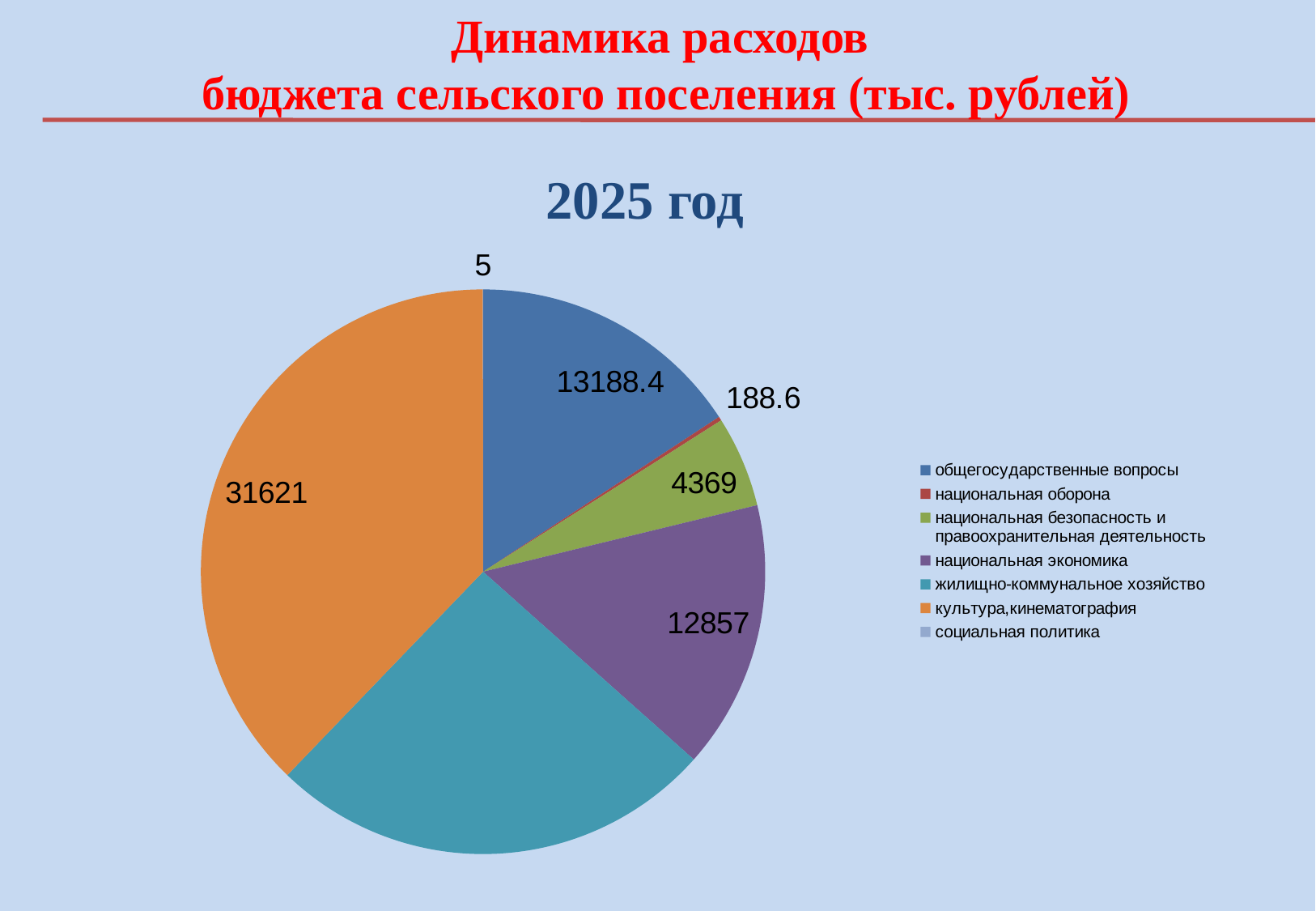
How many categories does the legend of the pie chart list? 7 What is the value for общегосударственные вопросы in the pie chart? 13188.4 What is the difference between the values for культура,кинематография and национальная экономика? 18764 What is the value for культура,кинематография in the pie chart? 31621 What kind of chart is shown on the slide? pie chart Which is larger: the value for общегосударственные вопросы or the value for национальная экономика? общегосударственные вопросы Which category has the smallest slice in the pie chart? социальная политика Which category has the largest slice in the pie chart? культура,кинематография What is the value for национальная безопасность и правоохранительная деятельность in the pie chart? 4369 What is the value for национальная оборона in the pie chart? 188.6 What is the value for социальная политика in the pie chart? 5 What is the value for национальная экономика in the pie chart? 12857